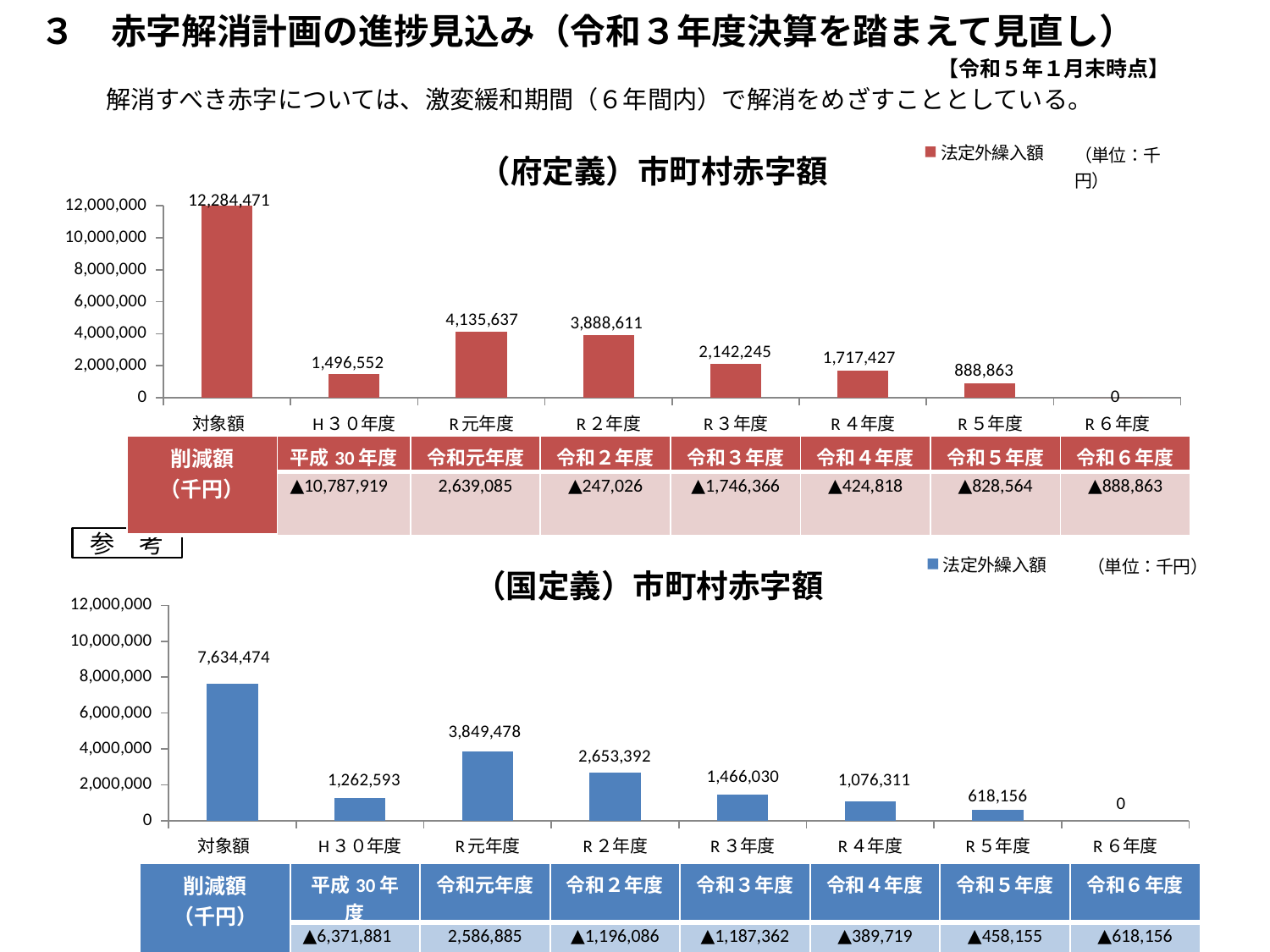
In the （府定義）市町村赤字額 chart, do the values rise or fall from R元年度 to R６年度? Fall In the （府定義）市町村赤字額 chart, what is the difference between the values for R元年度 and R２年度? 247,026 In the （府定義）市町村赤字額 chart, which category has the highest value? 対象額 In the （国定義）市町村赤字額 chart, what is the value for R５年度? 618,156 How many series does the legend of the （府定義）市町村赤字額 chart list? 1 How many categories are shown on the x axis of the （国定義）市町村赤字額 chart? 8 In the （国定義）市町村赤字額 chart, which is larger, the value for H３０年度 or the value for R４年度? H３０年度 In the （国定義）市町村赤字額 chart, what is the value for R元年度? 3,849,478 In the （府定義）市町村赤字額 chart, what is the value for 対象額? 12,284,471 In the （府定義）市町村赤字額 chart, what is the value for R３年度? 2,142,245 What kind of chart is the （国定義）市町村赤字額 chart? Bar chart In the （国定義）市町村赤字額 chart, which category has the lowest value? R６年度